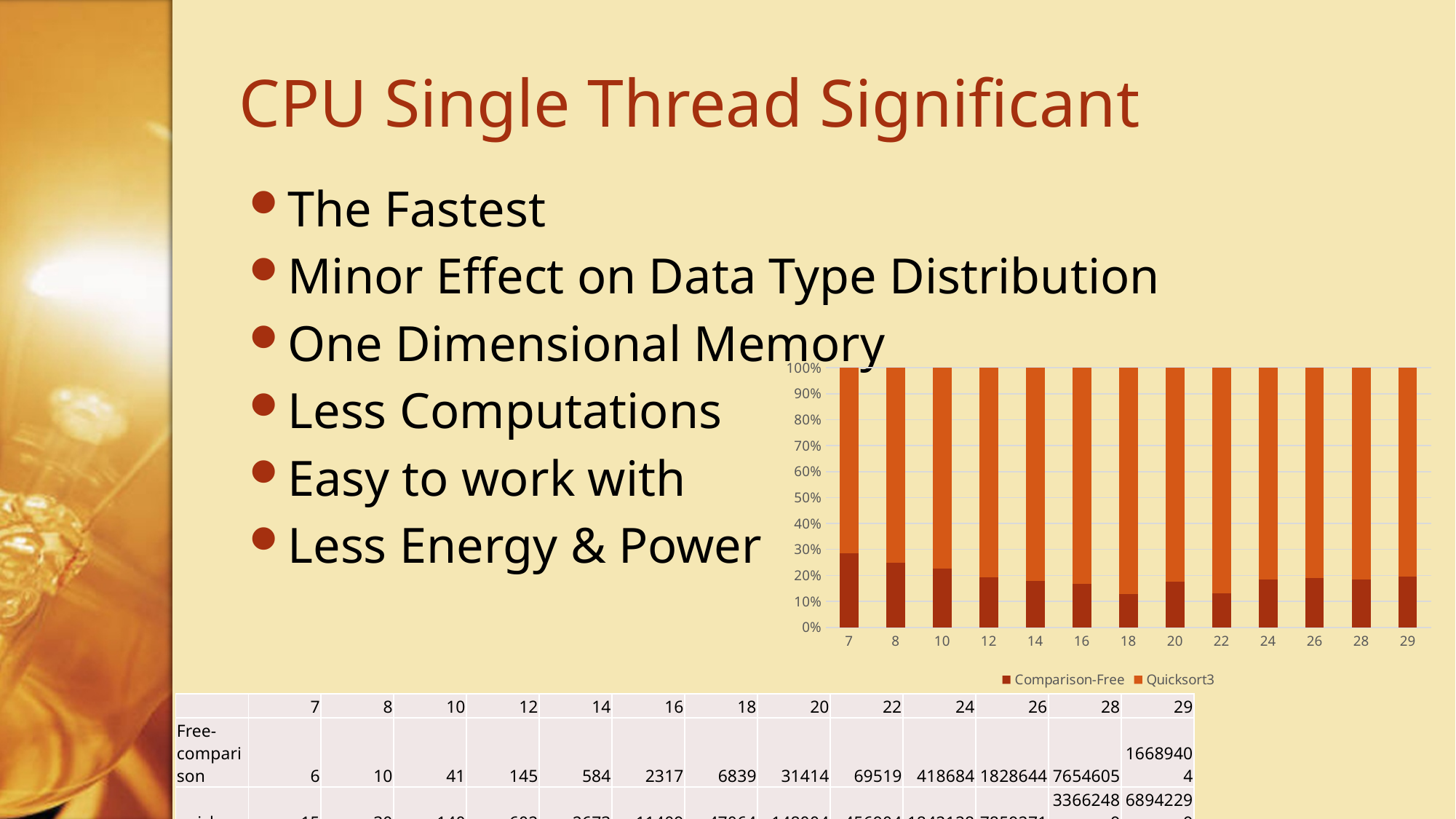
Which series is drawn in the darker red colour in the chart? Comparison-Free Is the Quicksort3 share for category 7 greater or less than 60%? greater How many series does the chart legend list? 2 Which category has the largest Comparison-Free share in the chart? 7 How many categories are shown along the x axis of the chart? 13 Which has the larger Quicksort3 share, category 18 or category 8? 18 Is the Comparison-Free share for category 7 greater or less than 20%? greater Is the Comparison-Free share for category 18 greater or less than 20%? less What kind of chart is shown on the slide? Stacked bar chart What are the two series named in the chart legend? Comparison-Free and Quicksort3 Which has the larger Comparison-Free share, category 7 or category 22? 7